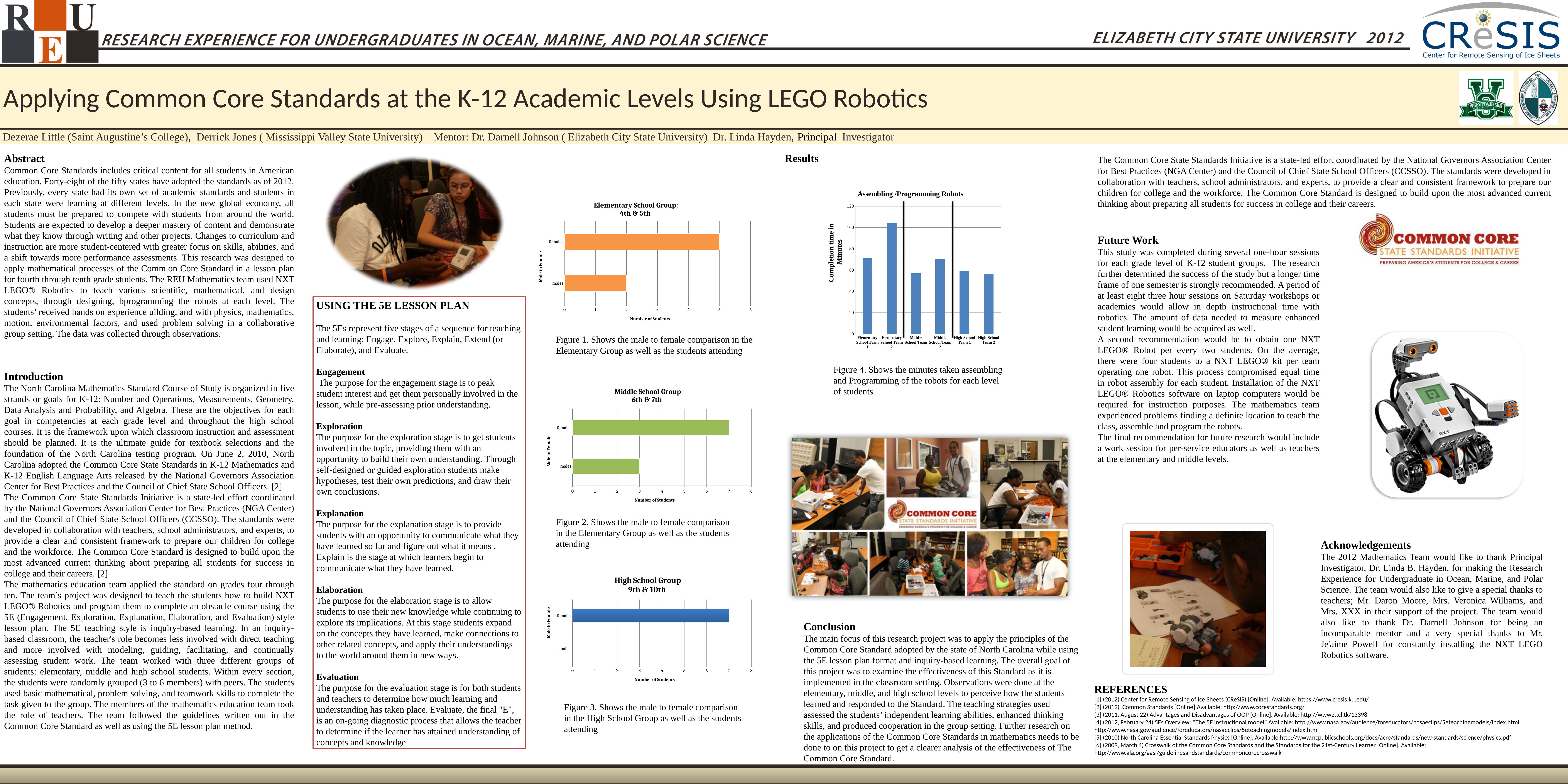
In the "High School Group 9th & 10th" chart, which category has the larger number of students, females or males? females In the "High School Group 9th & 10th" chart, how many female students are shown? 7 What kind of chart is the "Assembling /Programming Robots" chart? bar chart In the "Assembling /Programming Robots" chart, which team has the highest completion time? Elementary School Team 2 In the "Middle School Group 6th & 7th" chart, how many female students are shown? 7 In the "Elementary School Group: 4th & 5th" chart, what is the difference between the number of females and the number of males? 3 In the "Assembling /Programming Robots" chart, is the completion time for Elementary School Team 2 greater or less than 80? greater How many teams are plotted in the "Assembling /Programming Robots" chart? 6 In the "Assembling /Programming Robots" chart, is the completion time for Middle School Team 1 greater or less than 80? less In the "Elementary School Group: 4th & 5th" chart, how many female students are shown? 5 In the "Elementary School Group: 4th & 5th" chart, how many male students are shown? 2 In the "Middle School Group 6th & 7th" chart, how many male students are shown? 3